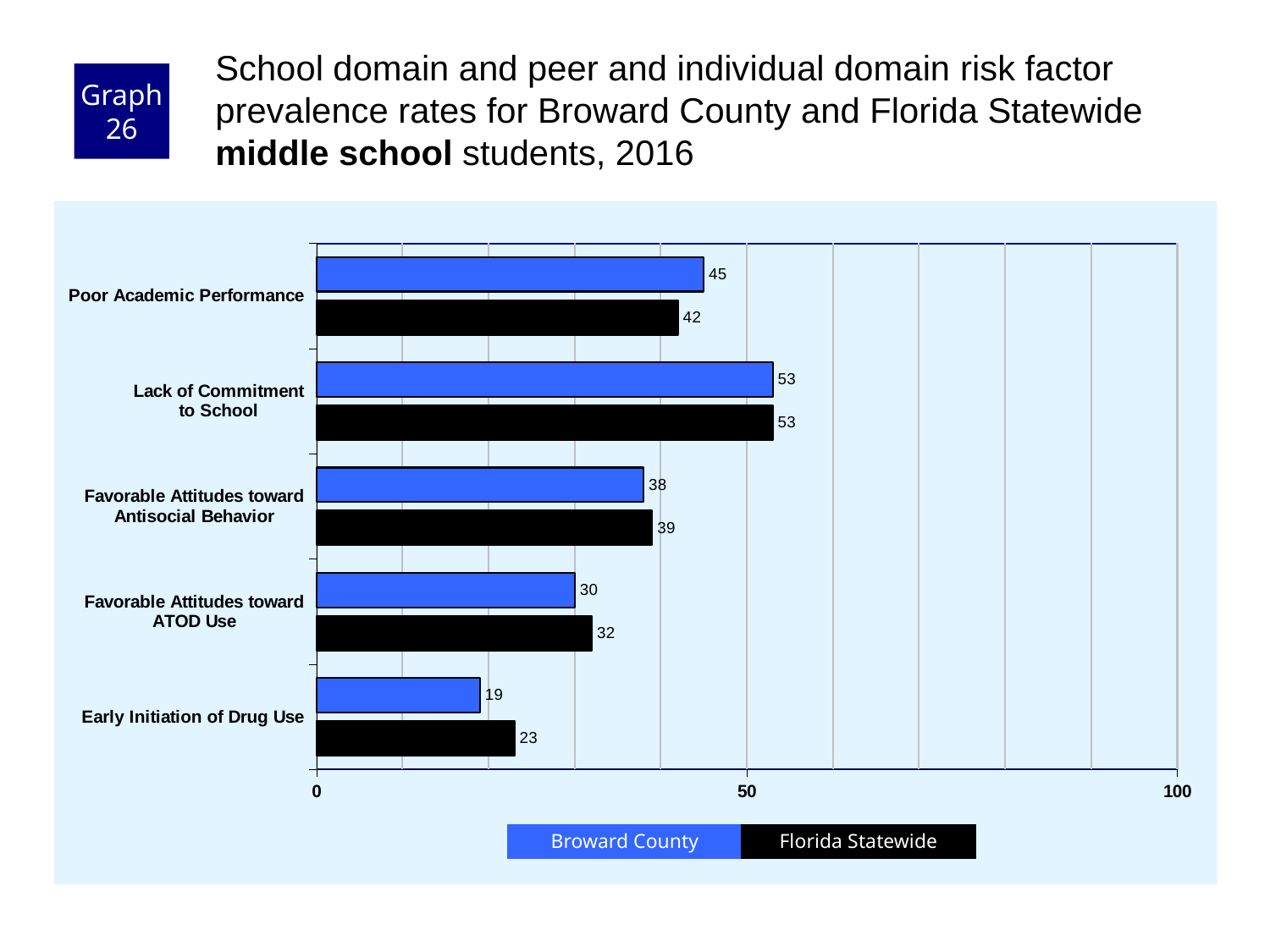
Which colour represents Florida Statewide in the chart? black What is the Broward County value for Poor Academic Performance? 45 What kind of chart is shown on the slide? bar chart What is the Florida Statewide value for Early Initiation of Drug Use? 23 Is the Broward County value for Lack of Commitment to School greater or less than 50? greater What is the Florida Statewide value for Favorable Attitudes toward ATOD Use? 32 What is the difference between the Florida Statewide and Broward County values for Early Initiation of Drug Use? 4 For Poor Academic Performance, which is larger: the Broward County value or the Florida Statewide value? Broward County How many series does the legend list? 2 Which risk factor has the lowest Florida Statewide value? Early Initiation of Drug Use Which risk factor has the highest Broward County value? Lack of Commitment to School How many risk factor categories are shown on the chart? 5